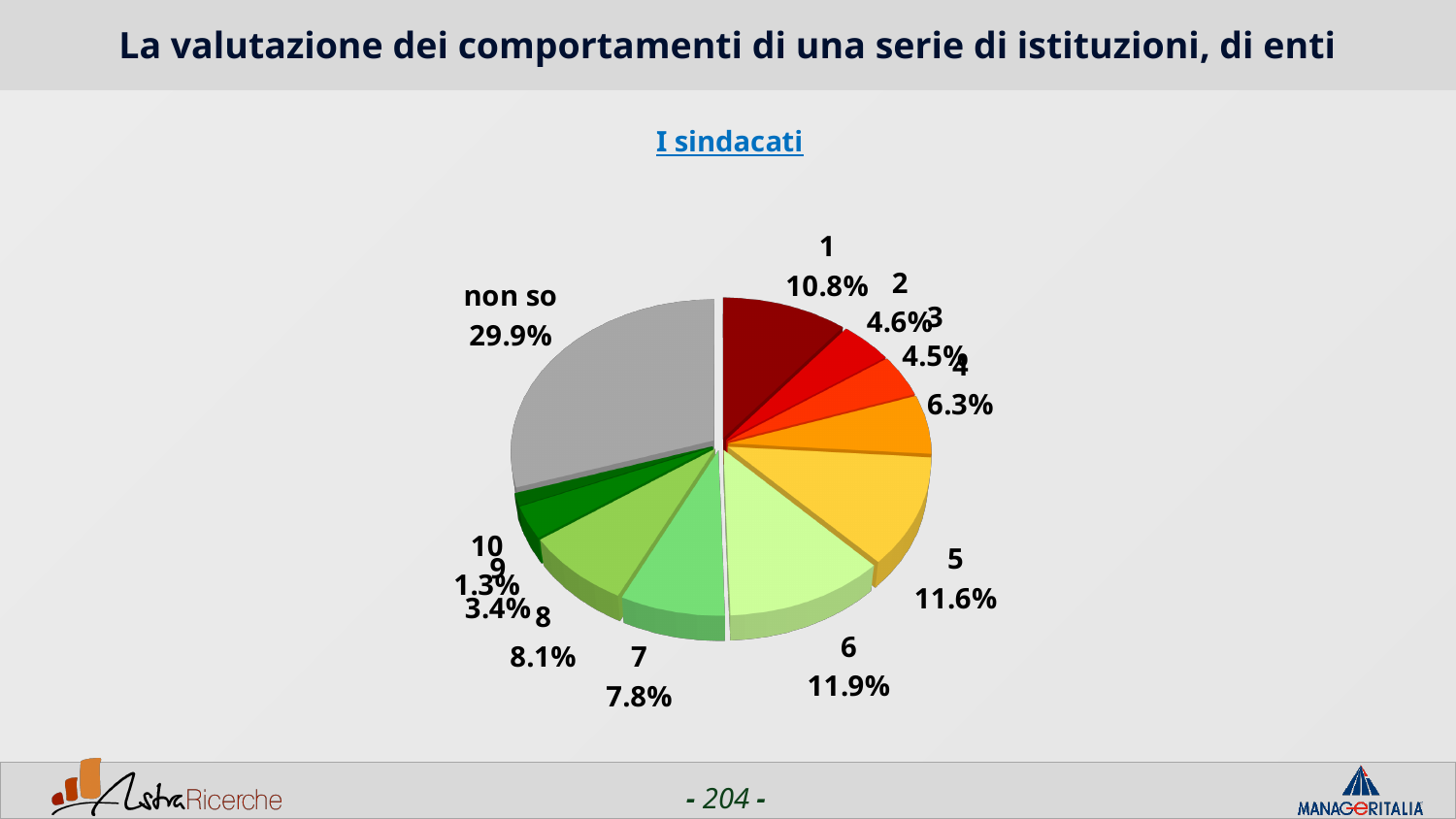
What type of chart is shown on the slide? pie chart What is the difference between the values for category 5 and category 1? 0.8% What is the value for 'non so' in the pie chart? 29.9% Which is larger, the value for category 2 or the value for category 4? 4 What is the subtitle of the pie chart? I sindacati What is the difference between the value for 'non so' and the value for category 6? 18.0% What is the value for category 6 in the pie chart? 11.9% Which category has the largest slice in the pie chart? non so What is the value for category 1 in the pie chart? 10.8% What is the combined share of categories 1 and 2 in the pie chart? 15.4% Which is larger, the value for category 7 or the value for category 8? 8 What is the value for category 4 in the pie chart? 6.3%